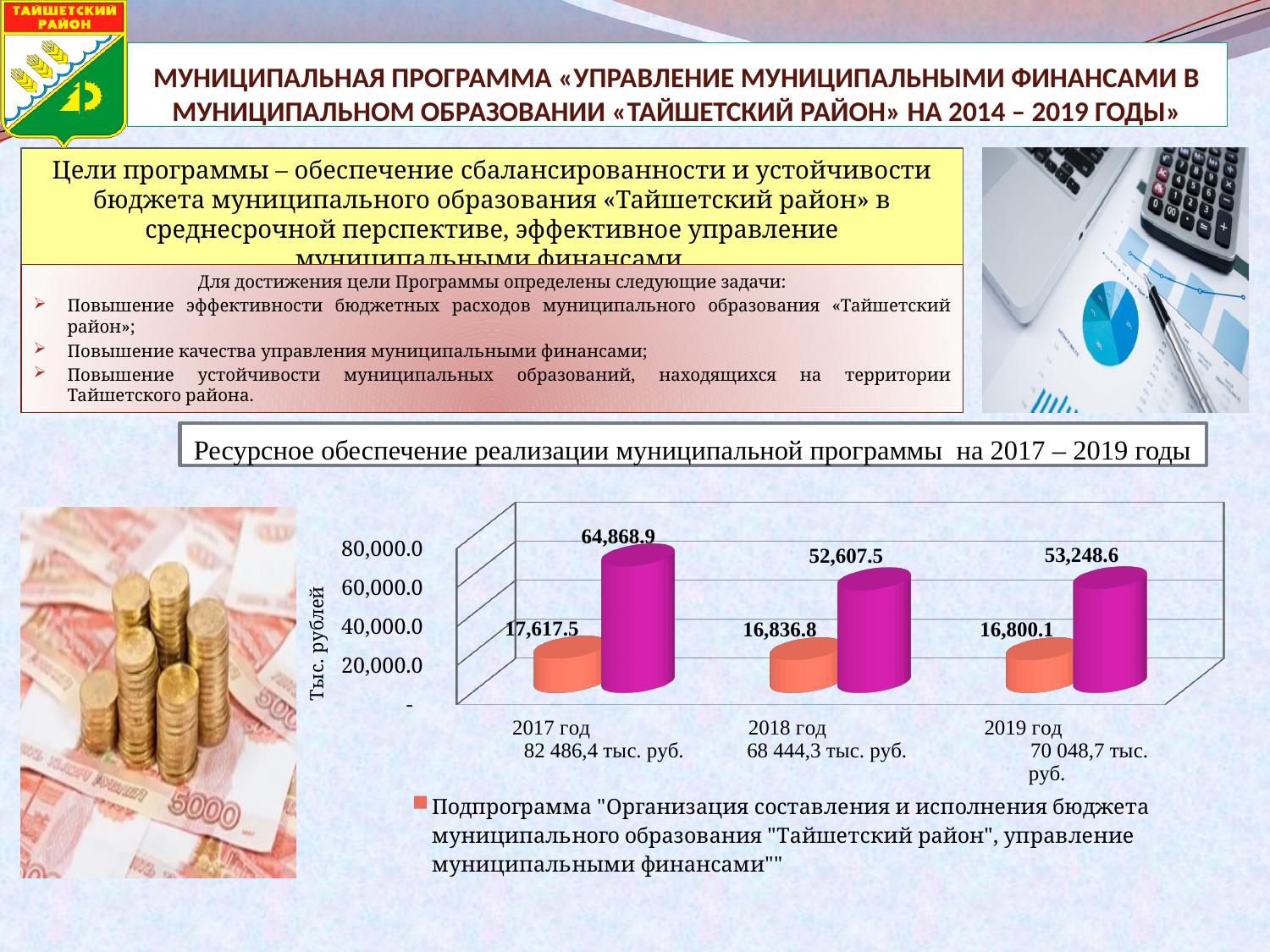
What is the difference between the magenta bar values for 2017 год and 2018 год? 12,261.4 Do the orange bar values rise or fall from 2017 год to 2019 год? fall In which year is the magenta bar the highest? 2017 год What unit is given on the vertical axis of the chart? Тыс. рублей What is the value of the orange bar for 2018 год? 16,836.8 Which is larger: the magenta bar for 2018 год or the magenta bar for 2019 год? 2019 год What is the value of the orange bar for 2017 год? 17,617.5 What type of chart is shown on the slide? bar chart In which year is the orange bar the lowest? 2019 год What is the value of the magenta bar for 2019 год? 53,248.6 How many years (categories) are shown on the x axis of the chart? 3 What is the value of the magenta bar for 2017 год? 64,868.9